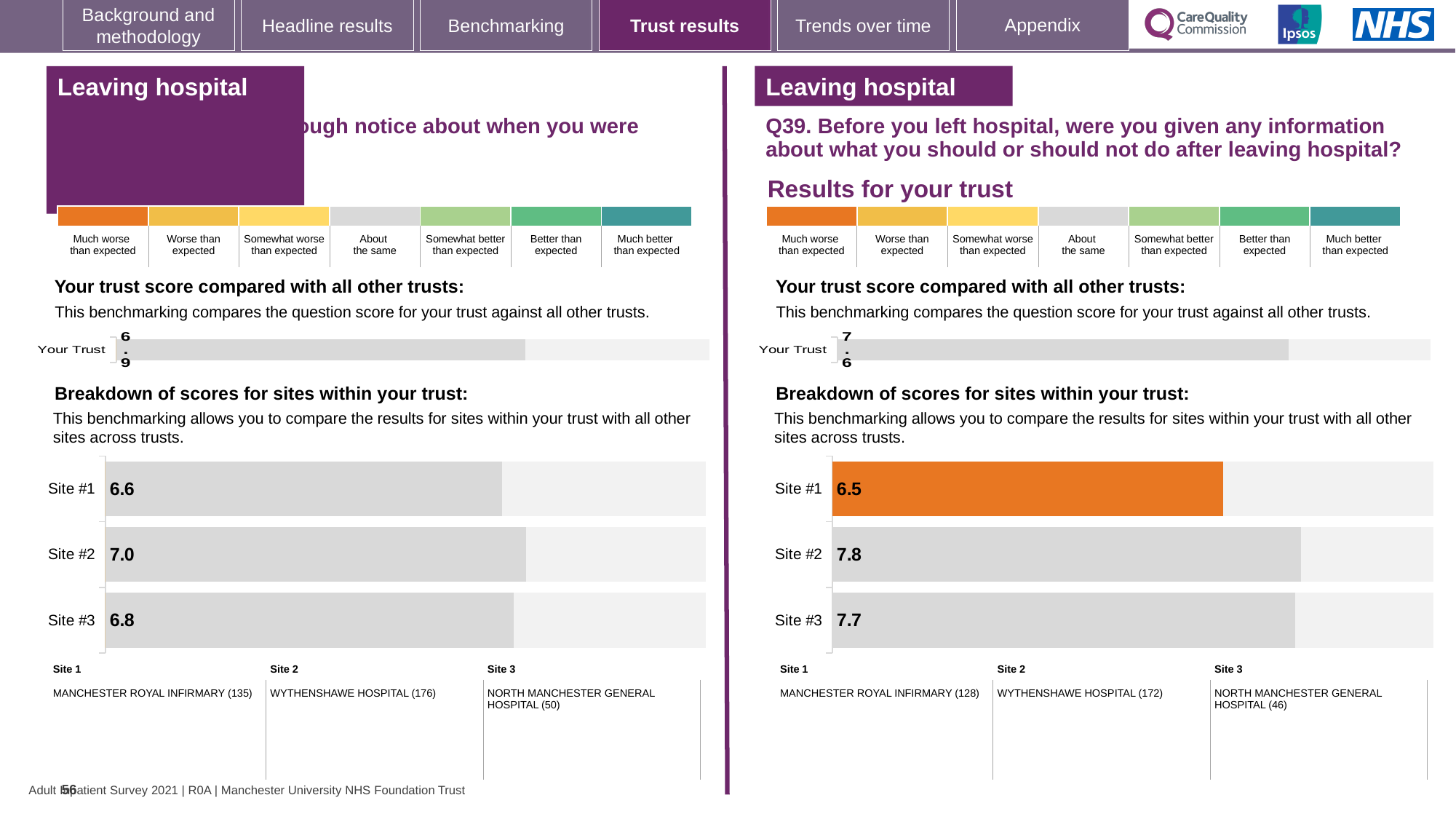
On the right-hand (Q39) site breakdown chart, which site has the lowest score? Site #1 What type of chart is used for the site breakdown on the right-hand (Q39) side of the slide? Bar chart On the right-hand (Q39) site breakdown chart, which site's bar is coloured orange? Site #1 On the left-hand site breakdown chart, which has the larger score, Site #1 or Site #3? Site #3 On the left-hand 'Your trust score compared with all other trusts' chart, what is the score for Your Trust? 6.9 On the right-hand (Q39) site breakdown chart, what is the score for Site #2? 7.8 On the left-hand site breakdown chart, what is the score for Site #1? 6.6 On the right-hand (Q39) site breakdown chart, what is the difference between the scores for Site #2 and Site #1? 1.3 On the left-hand site breakdown chart, which site has the highest score? Site #2 On the right-hand (Q39) 'Your trust score compared with all other trusts' chart, what is the score for Your Trust? 7.6 How many sites are shown on the right-hand (Q39) site breakdown chart? 3 On the left-hand site breakdown chart, what is the difference between the scores for Site #2 and Site #3? 0.2